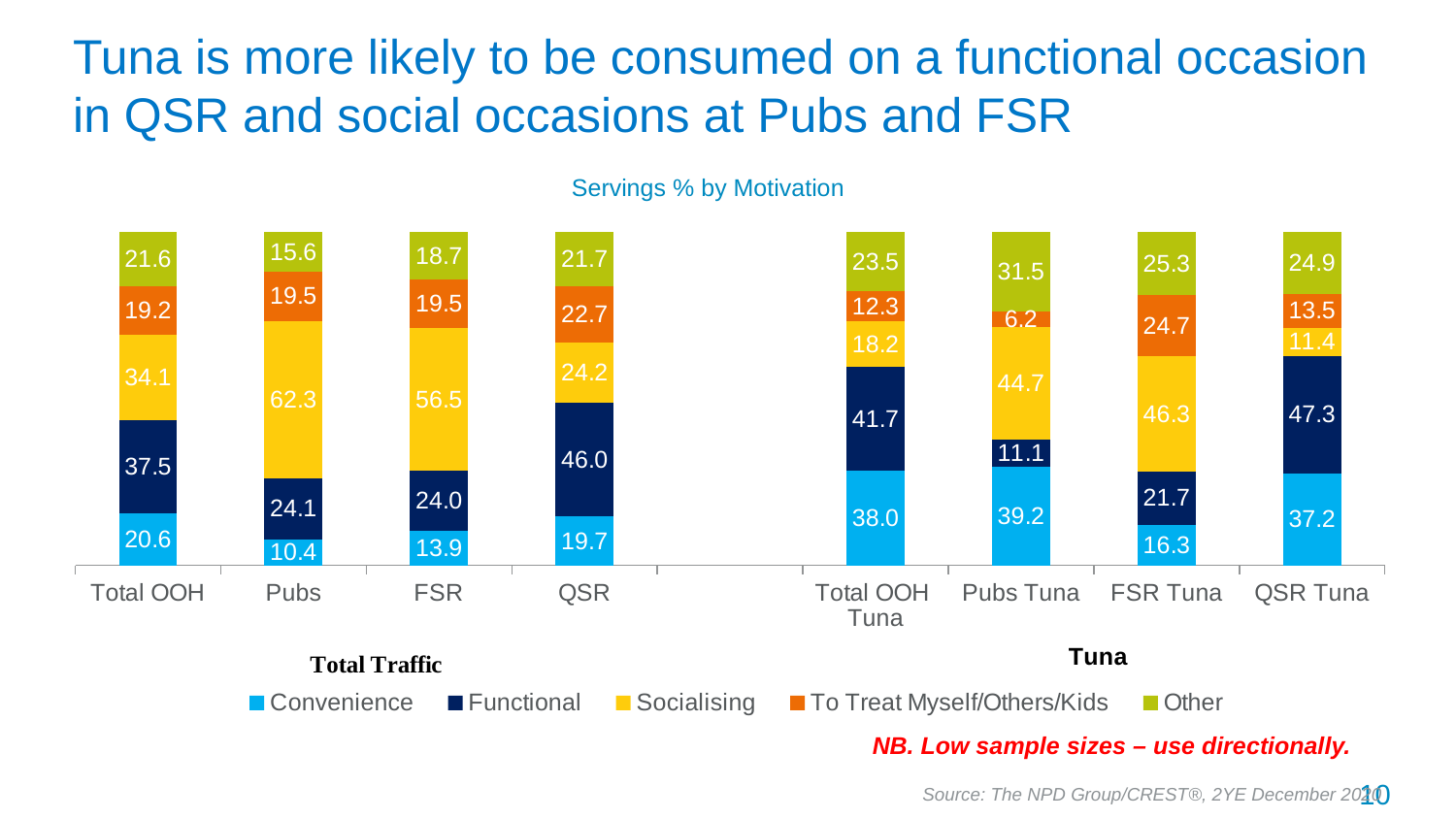
What is the Other value for Pubs Tuna? 31.5 What is the title of the chart? Servings % by Motivation What is the Functional value for QSR Tuna? 47.3 What is the total of the stacked bar for Pubs Tuna? 132.7 How many series does the legend list? 5 How many categories are shown on the x axis? 8 What kind of chart is shown on the slide? Stacked bar chart What is the difference between the Socialising value for Pubs and for Pubs Tuna? 17.6 Which category has the highest Socialising value? Pubs Which category has the lowest Convenience value? Pubs What is the Socialising value for Pubs? 62.3 Which is larger, the Convenience value for Total OOH Tuna or for Pubs Tuna? Pubs Tuna